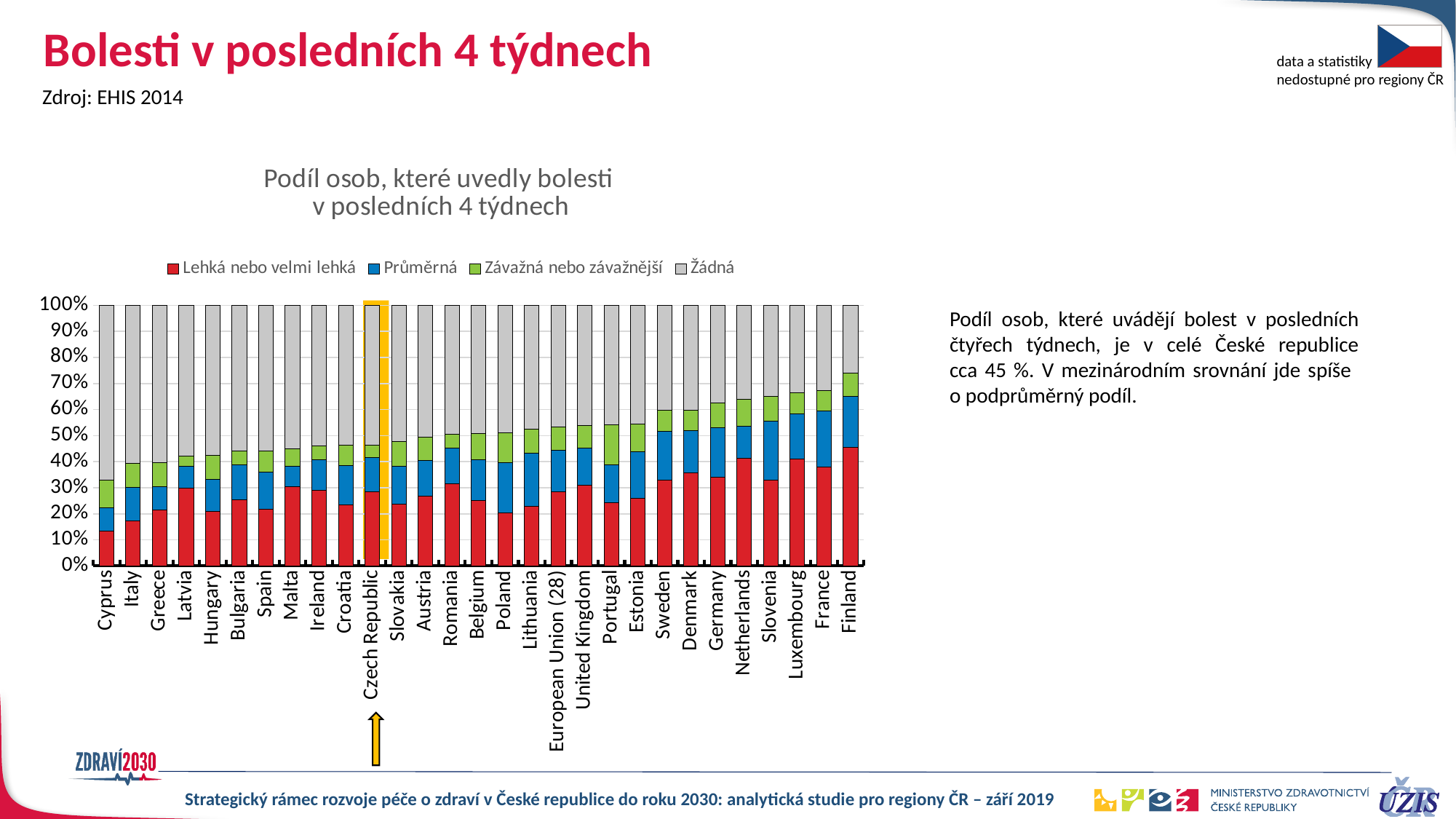
How many countries/categories are shown on the x axis of the chart? 29 Which country is highlighted with a yellow box and arrow in the chart? Czech Republic Which country has the largest 'Lehká nebo velmi lehká' (red) segment? Finland How many series does the chart legend list? 4 Which has the larger 'Lehká nebo velmi lehká' (red) segment, Czech Republic or Finland? Finland Which country has the largest 'Žádná' (grey) segment? Cyprus Which country has the smallest 'Žádná' (grey) segment? Finland Moving from left to right along the x axis, does the 'Žádná' (grey) share rise or fall? Fall What kind of chart is shown on the slide? Stacked bar chart Which country has the smallest 'Lehká nebo velmi lehká' (red) segment? Cyprus Is the 'Lehká nebo velmi lehká' value for Cyprus greater or less than 20%? less Is the 'Lehká nebo velmi lehká' value for Finland greater or less than 40%? greater